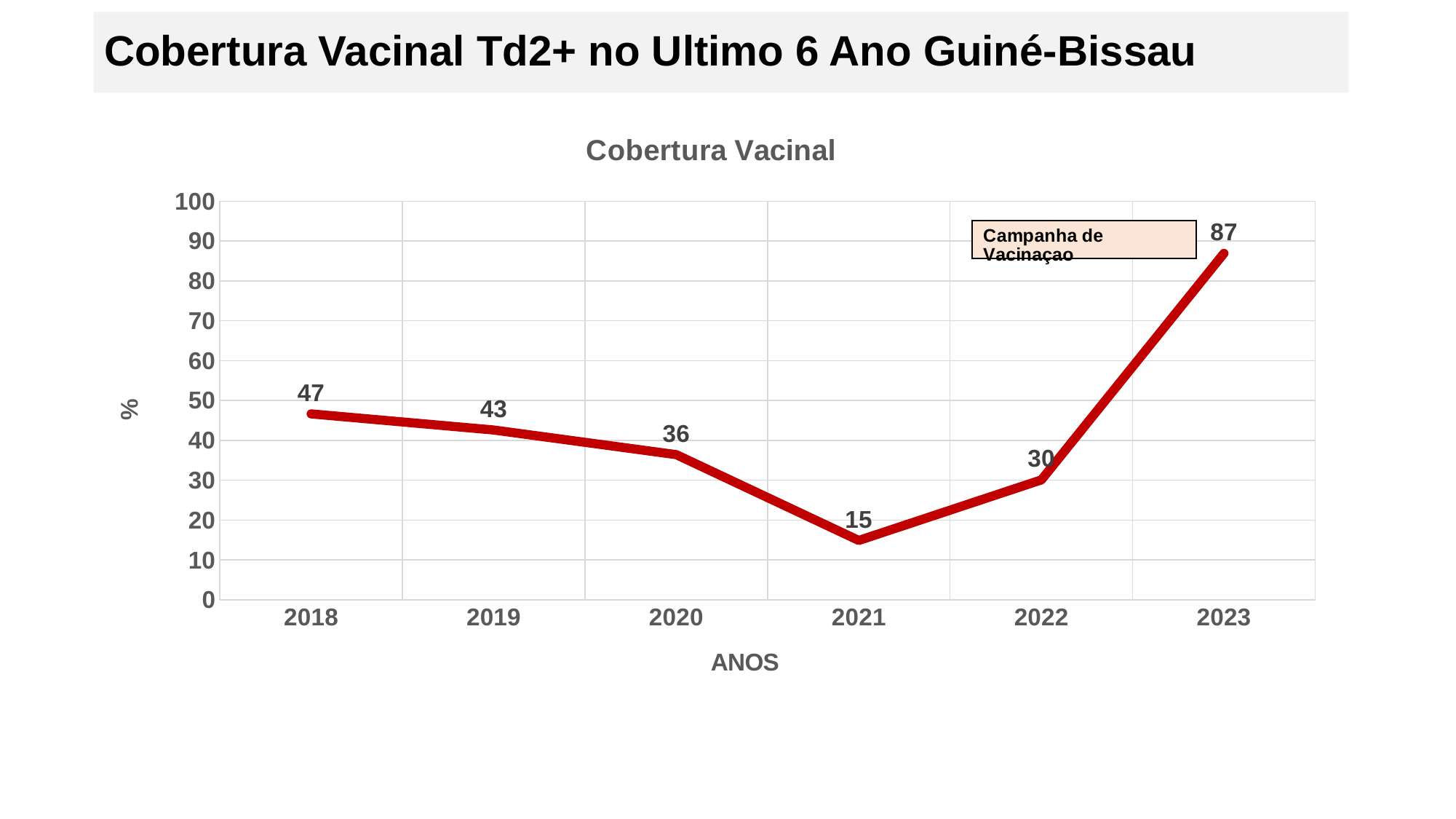
What is the difference between the values for 2023 and 2022? 57 What is the value for 2018? 47 Which is larger, the value for 2019 or the value for 2022? 2019 What is the title of the chart? Cobertura Vacinal Do the values rise or fall from 2018 to 2021? fall Which year has the lowest value? 2021 What is the value for 2021? 15 What kind of chart is this? line chart How many years are plotted on the x axis? 6 What is the difference between the values for 2018 and 2020? 11 What is the value for 2023? 87 Which year has the highest value? 2023